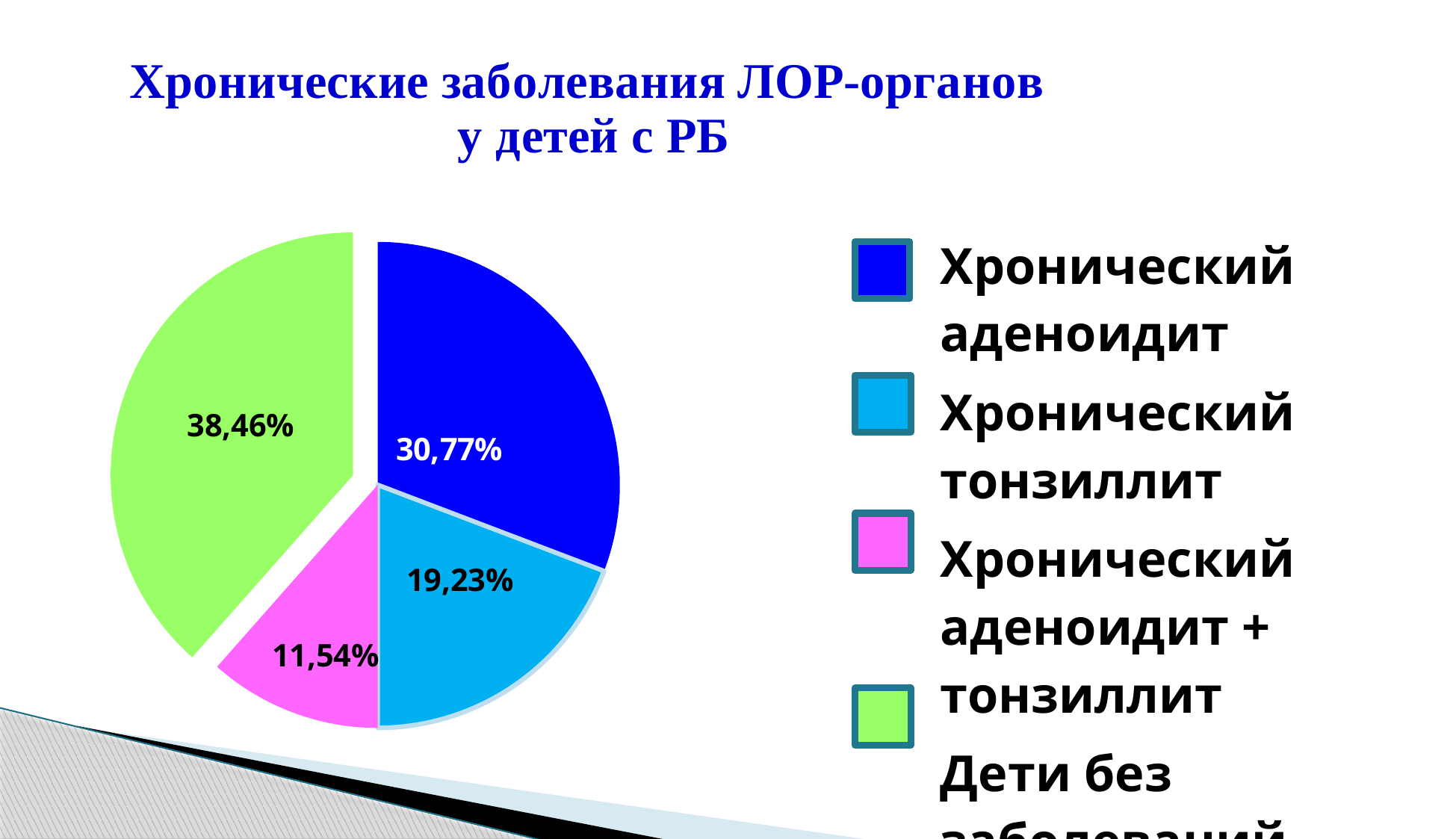
Which category has the smallest slice of the pie? Хронический аденоидит + тонзиллит What kind of chart is shown on the slide? pie chart What share of the pie is labelled for Хронический аденоидит + тонзиллит? 11,54% Which slice of the pie is the largest? the green slice, 38,46% What share of the pie is labelled for Хронический аденоидит? 30,77% How many slices does the pie chart have? 4 Which is larger: the share for Хронический аденоидит or for Хронический тонзиллит? Хронический аденоидит What colour is the slice for Хронический тонзиллит? light blue What is the difference between the shares for Хронический аденоидит and Хронический тонзиллит? 11,54% What percentage is printed on the green slice of the pie? 38,46% What share of the pie is labelled for Хронический тонзиллит? 19,23% What is the combined share of the three chronic disease slices (Хронический аденоидит, Хронический тонзиллит, and Хронический аденоидит + тонзиллит)? 61,54%